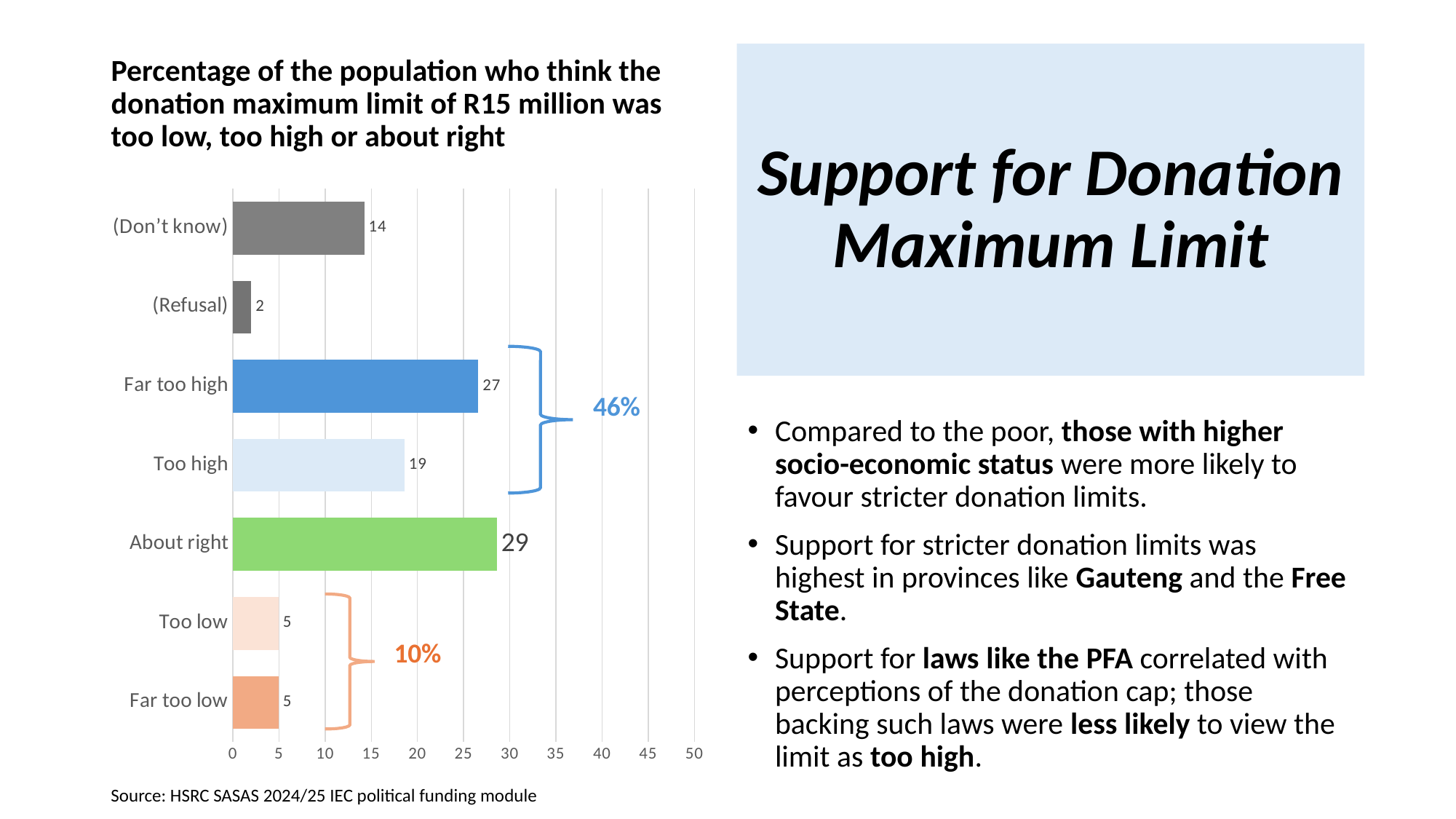
What kind of chart is shown on the slide? Bar chart What combined percentage is shown by the bracket grouping "Too low" and "Far too low"? 10% What combined percentage is shown by the bracket grouping "Far too high" and "Too high"? 46% What is the value for "Far too high"? 27 Which category has the highest value? About right What is the difference between the values for "Far too high" and "Too high"? 8 Which category has the lowest value? (Refusal) What is the value for "About right"? 29 Which is larger, the value for "Too high" or the value for "(Don't know)"? Too high How many categories are shown on the chart? 7 What is the value for "(Don't know)"? 14 What is the value for "(Refusal)"? 2